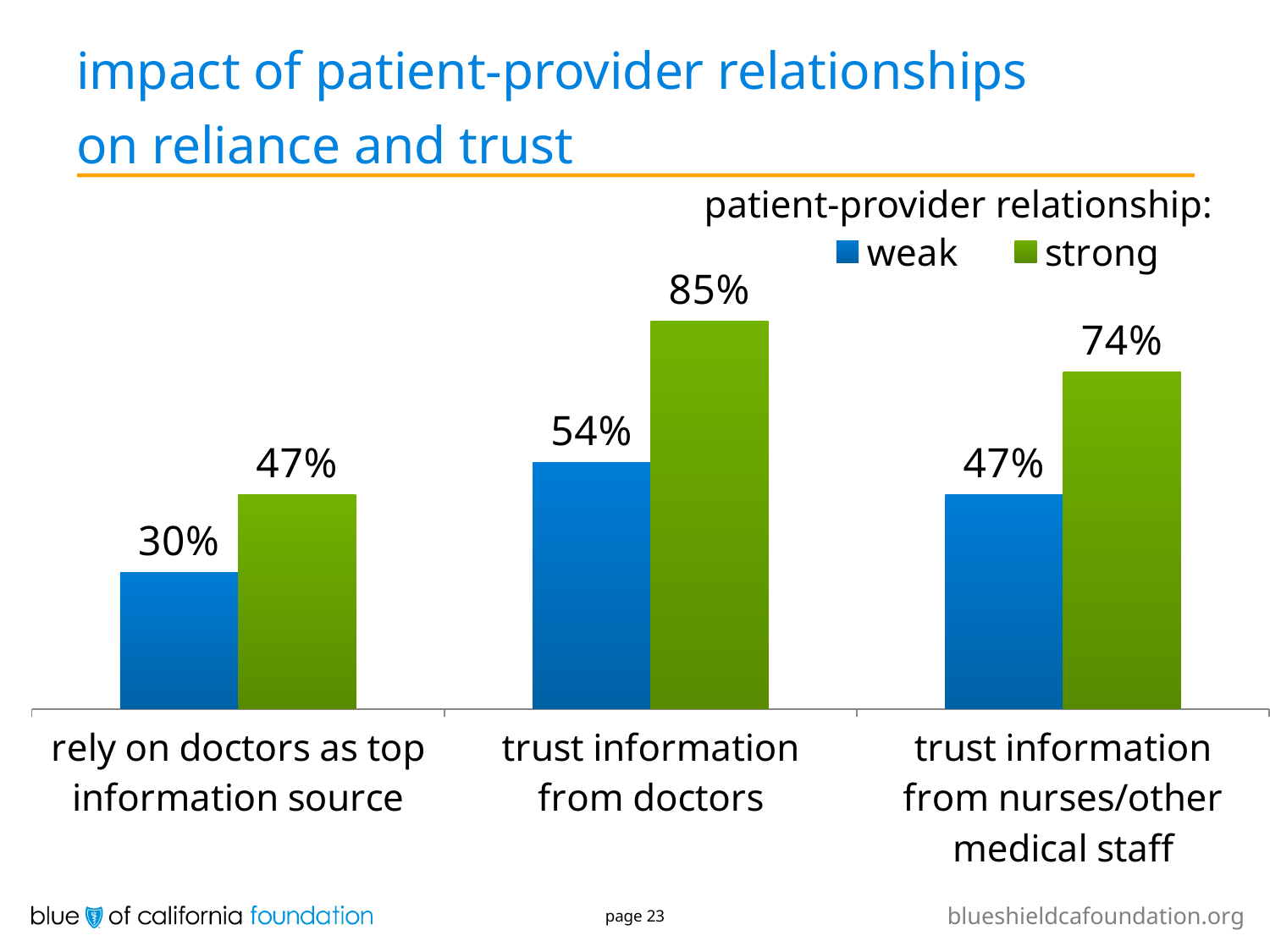
Which category has the highest value for the 'strong' series? trust information from doctors What is the value for 'strong' in the 'trust information from nurses/other medical staff' category? 74% Which is larger: the 'weak' value for 'trust information from doctors' or the 'strong' value for 'rely on doctors as top information source'? the 'weak' value for 'trust information from doctors' What kind of chart is shown on the slide? bar chart What is the value for 'weak' in the 'rely on doctors as top information source' category? 30% What is the value for 'strong' in the 'trust information from doctors' category? 85% What is the value for 'weak' in the 'trust information from nurses/other medical staff' category? 47% Which category has the lowest value for the 'weak' series? rely on doctors as top information source How many series does the legend list? 2 What is the difference between the 'strong' and 'weak' values in the 'rely on doctors as top information source' category? 17% How many categories are shown on the x axis? 3 What is the difference between the 'strong' and 'weak' values in the 'trust information from doctors' category? 31%